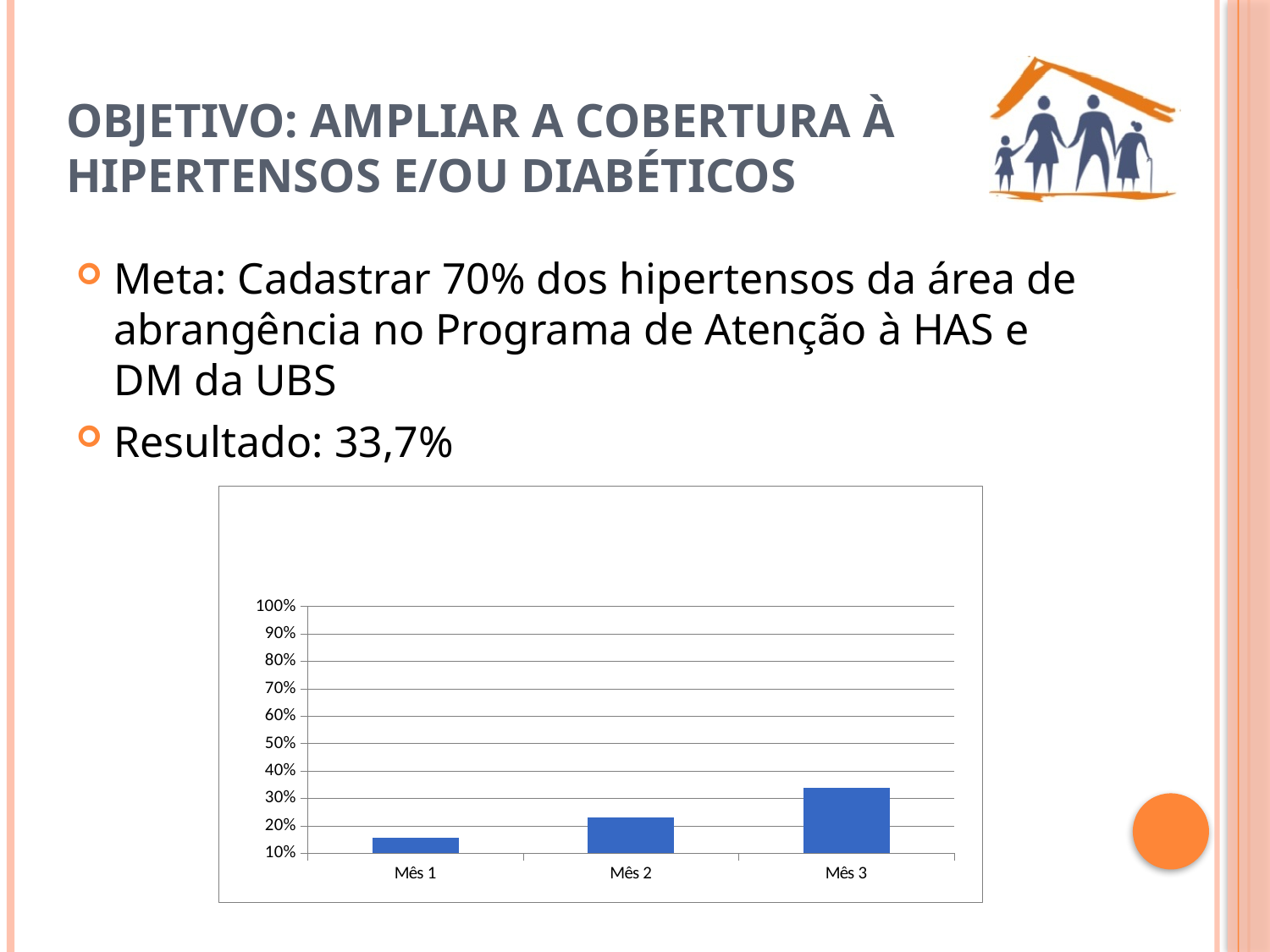
Which is larger, the value for Mês 1 or the value for Mês 2? Mês 2 Which month has the lowest bar in the chart? Mês 1 What is the highest value shown on the chart's y axis? 100% Is the value for Mês 1 greater or less than 20%? less Which is larger, the value for Mês 2 or the value for Mês 3? Mês 3 What kind of chart is shown on the slide? bar chart Is the value for Mês 3 greater or less than 40%? less Is the value for Mês 3 greater or less than 30%? greater How many categories are plotted on the x axis of the chart? 3 Which month has the highest bar in the chart? Mês 3 Do the values rise or fall from Mês 1 to Mês 3? rise